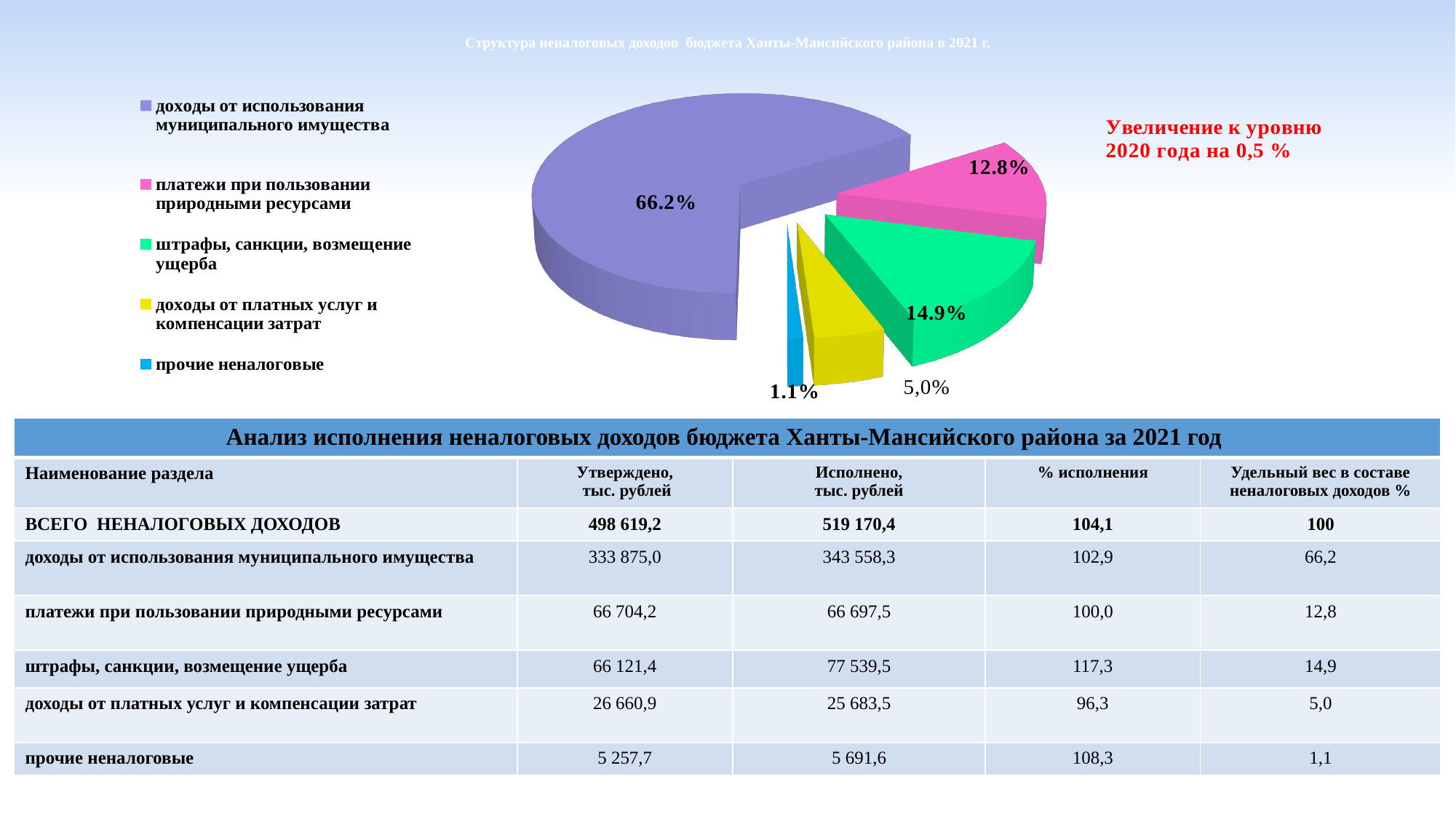
What is the difference in percentage points between the "штрафы, санкции, возмещение ущерба" slice and the "платежи при пользовании природными ресурсами" slice? 2.1 Which slice is larger in the pie chart: "штрафы, санкции, возмещение ущерба" or "платежи при пользовании природными ресурсами"? штрафы, санкции, возмещение ущерба What share of the pie chart does "платежи при пользовании природными ресурсами" have? 12.8% How many slices does the pie chart have? 5 What share of the pie chart does "доходы от платных услуг и компенсации затрат" have? 5,0% What share of the pie chart does "доходы от использования муниципального имущества" have? 66.2% What type of chart is shown on the slide? pie chart What share of the pie chart does "прочие неналоговые" have? 1.1% What share of the pie chart does "штрафы, санкции, возмещение ущерба" have? 14.9% Which category has the largest slice in the pie chart? доходы от использования муниципального имущества Which category has the smallest slice in the pie chart? прочие неналоговые What colour is the slice for "прочие неналоговые" in the pie chart? blue